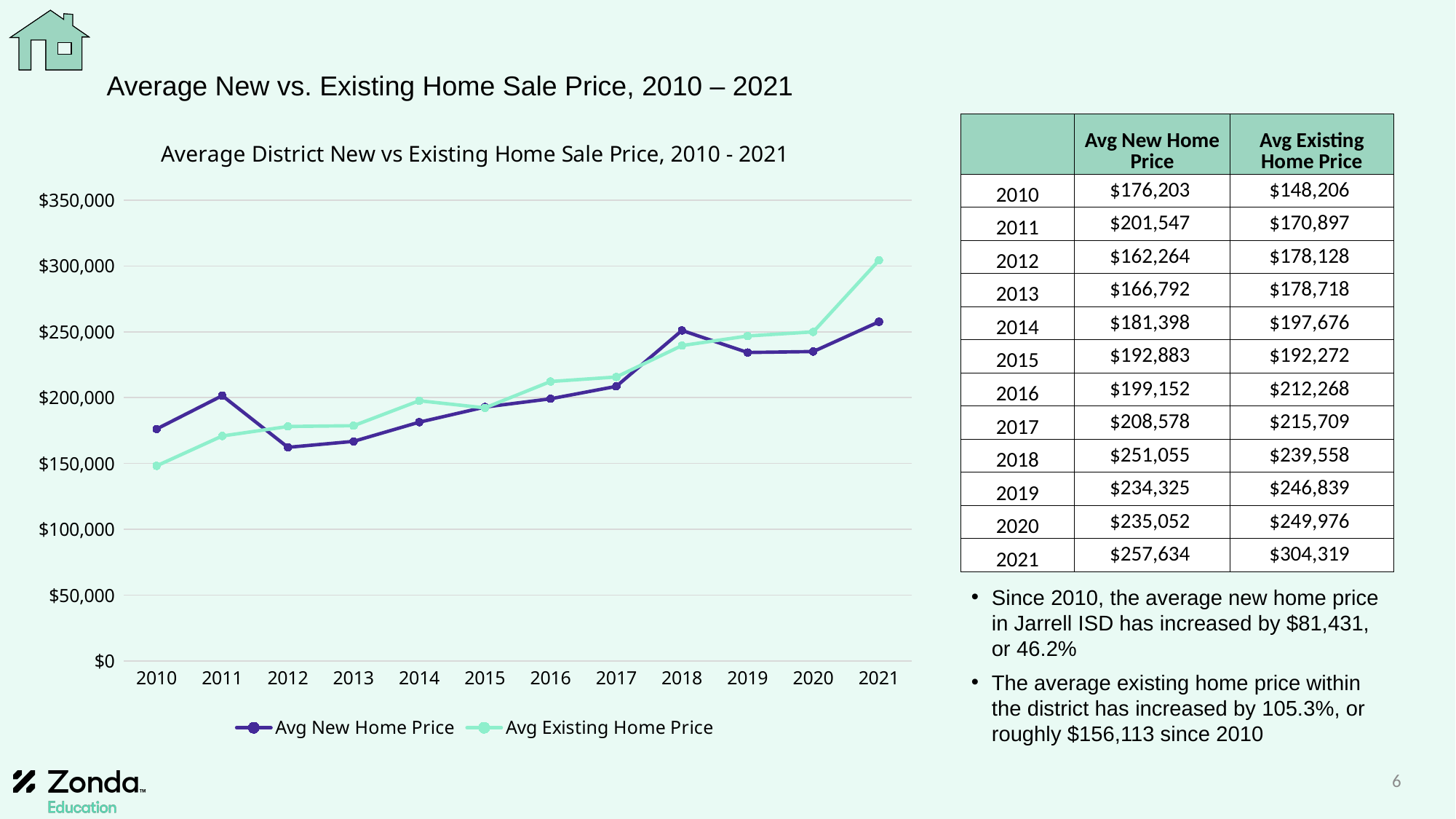
In which year is the Avg New Home Price lowest? 2012 In which year is the Avg Existing Home Price highest? 2021 Is the Avg Existing Home Price for 2021 greater or less than $300,000? greater How many years are plotted along the x axis of the chart? 12 What is the Avg New Home Price for 2010? $176,203 What kind of chart is shown on the slide? Line chart What is the difference between the Avg New Home Price and the Avg Existing Home Price in 2010? $27,997 In 2018, which is larger: the Avg New Home Price or the Avg Existing Home Price? Avg New Home Price How many series does the chart legend list? 2 What is the difference between the Avg Existing Home Price and the Avg New Home Price in 2021? $46,685 What is the Avg Existing Home Price for 2021? $304,319 Does the Avg Existing Home Price generally rise or fall from 2010 to 2021? Rise